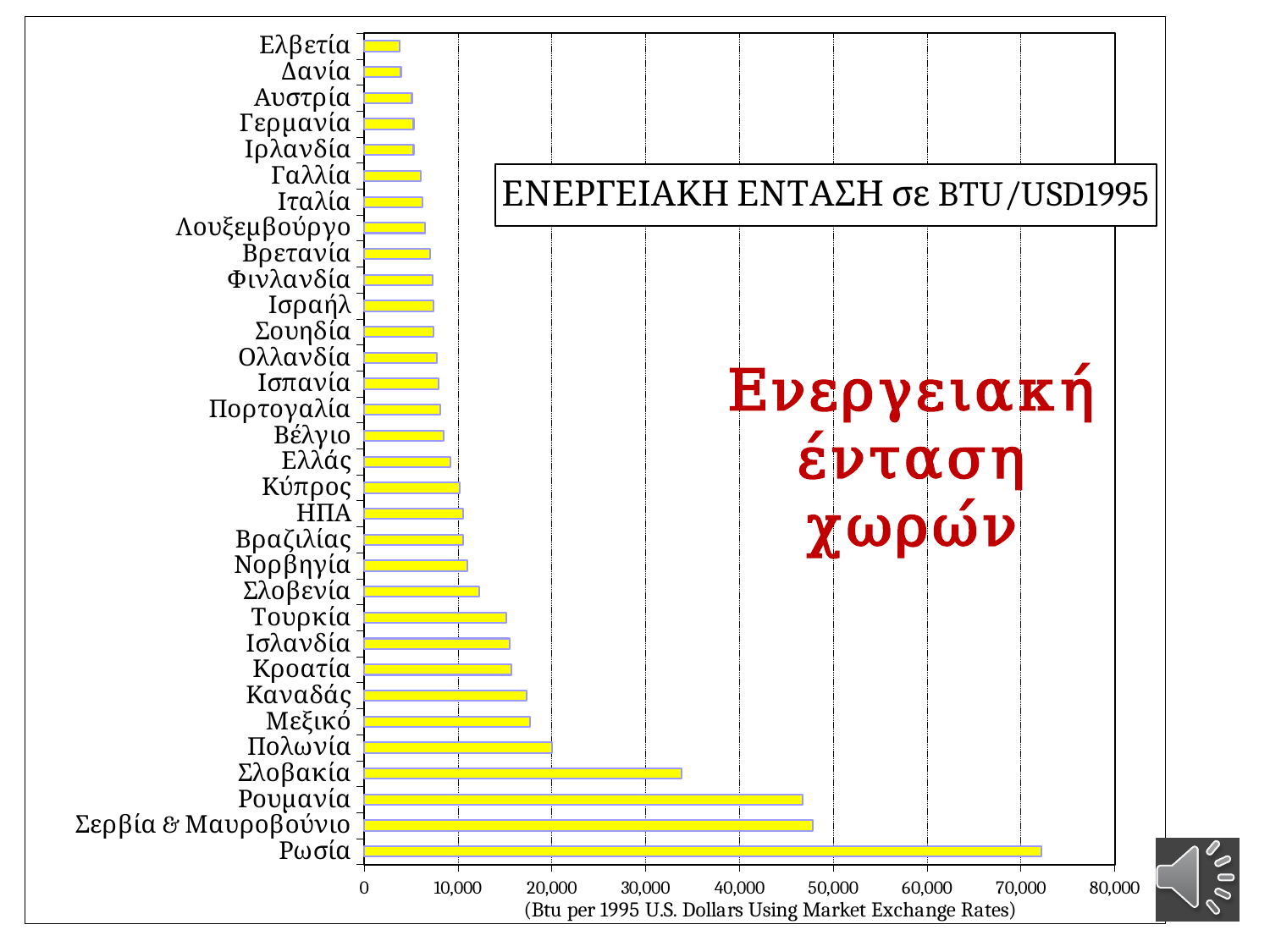
Is the value for Τουρκία greater or less than 10,000? greater Is the value for Ελλάς greater or less than 10,000? less Which country has the highest energy intensity in the chart? Ρωσία Is the value for Ρωσία greater or less than 70,000? greater How many countries are listed in the chart? 32 What kind of chart is shown on the slide? bar chart Which has the larger value, Ρουμανία or Σλοβακία? Ρουμανία What is the title shown in the box on the chart? ΕΝΕΡΓΕΙΑΚΗ ΕΝΤΑΣΗ σε BTU/USD1995 Which has the larger value, Πολωνία or Μεξικό? Πολωνία